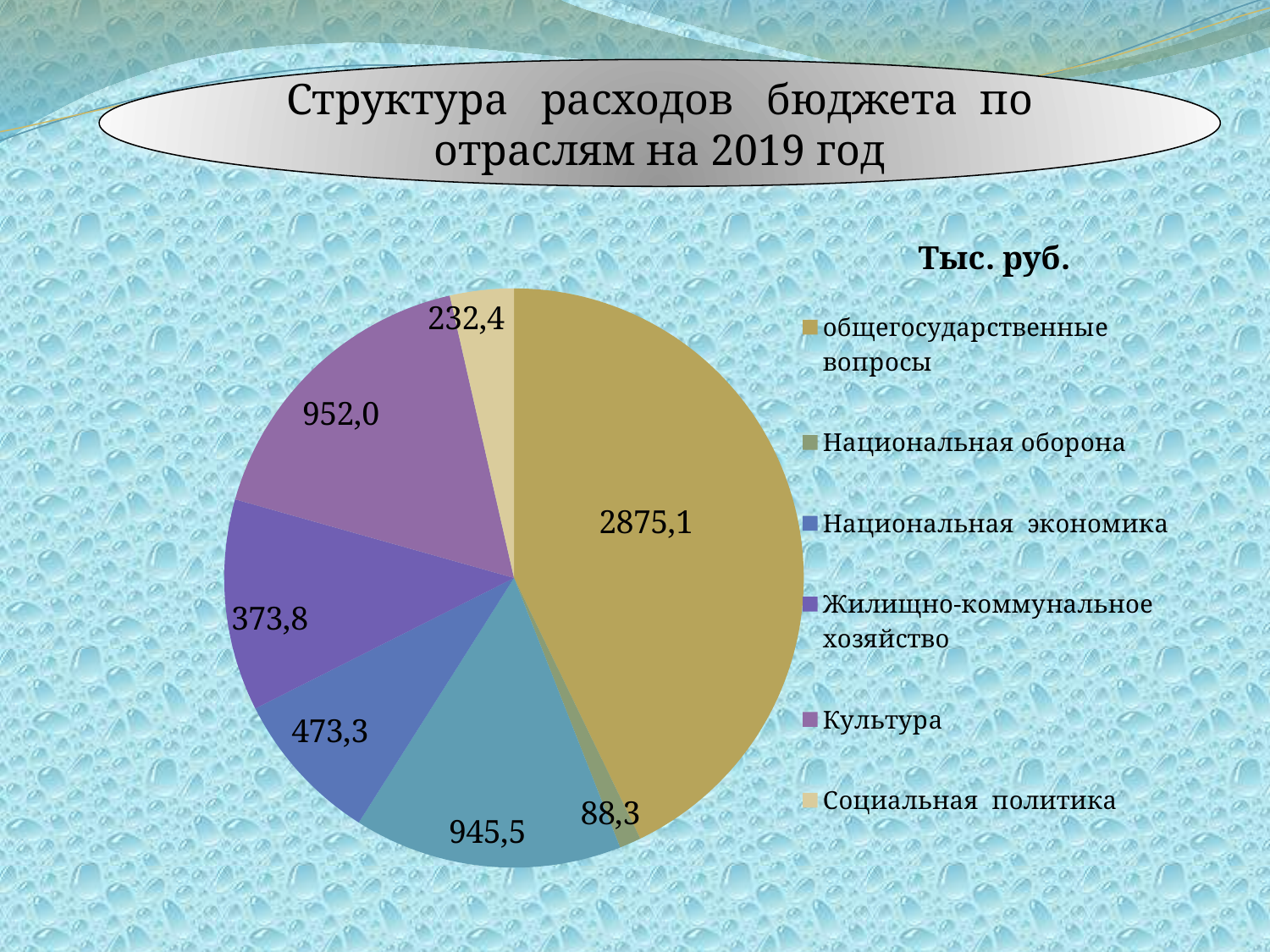
What is the value for общегосударственные вопросы? 2875,1 How many slices does the pie chart have? 7 Which category has the smallest slice of the pie? Национальная оборона Which is larger, the value for Культура or the value for Социальная политика? Культура What is the difference between the values for Культура and Социальная политика? 719,6 What is the value for Социальная политика? 232,4 What is the value for Национальная оборона? 88,3 What unit is indicated above the legend? Тыс. руб. What kind of chart is shown on the slide? pie chart What is the value for Культура? 952,0 How many entries does the legend list? 6 Which category has the largest slice of the pie? общегосударственные вопросы